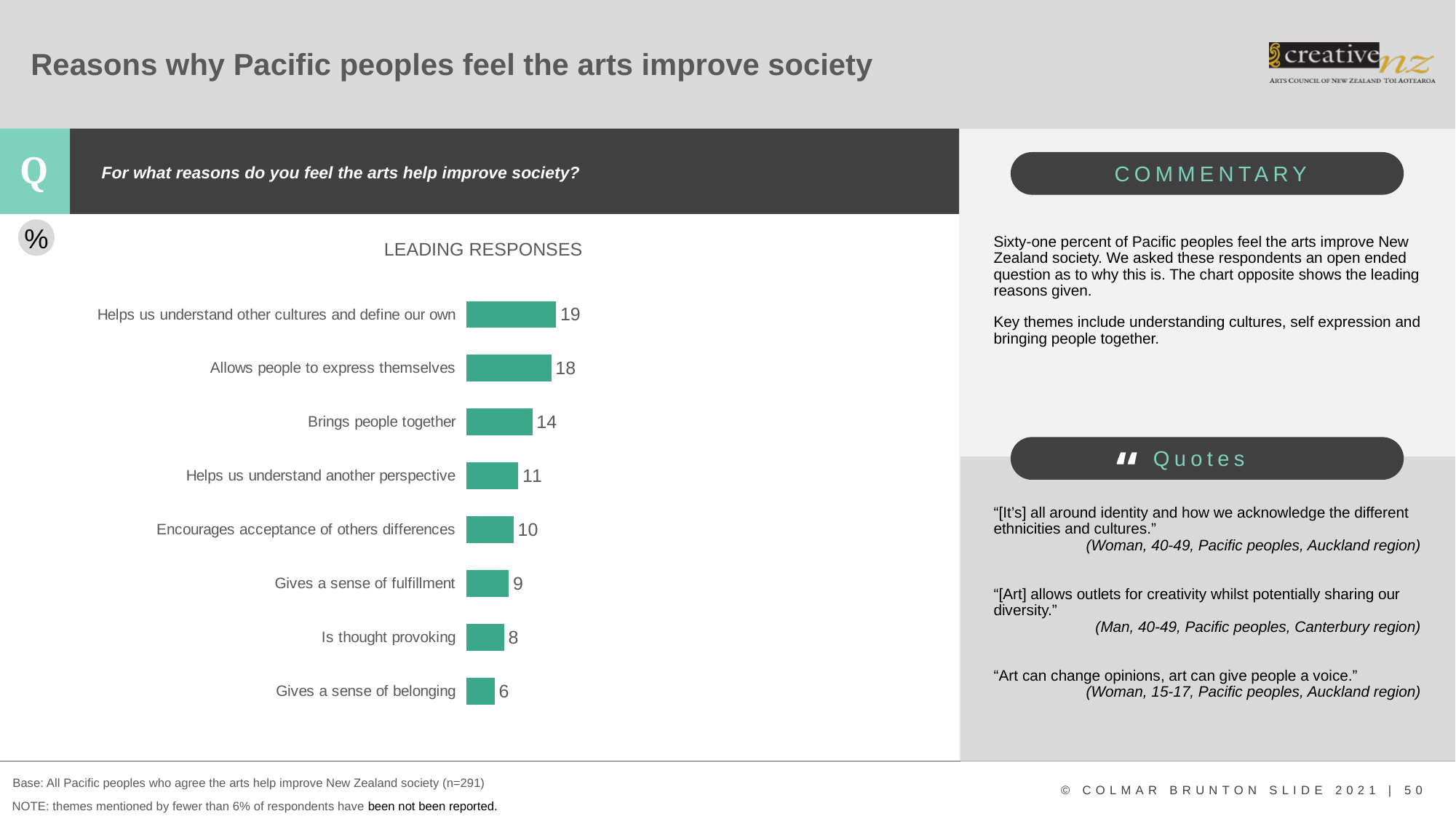
How many reasons are plotted in the chart? 8 What value is shown for "Is thought provoking"? 8 What is the difference between the values for "Brings people together" and "Gives a sense of belonging"? 8 Which reason has the lowest value? Gives a sense of belonging What value is shown for "Brings people together"? 14 What kind of chart is shown on the slide? Bar chart Which is larger: the value for "Helps us understand another perspective" or the value for "Encourages acceptance of others differences"? Helps us understand another perspective What value is shown for "Helps us understand other cultures and define our own"? 19 What is the title shown above the chart? LEADING RESPONSES What is the difference between the values for "Allows people to express themselves" and "Gives a sense of fulfillment"? 9 Which reason has the highest value? Helps us understand other cultures and define our own What colour are the bars in the chart? Green